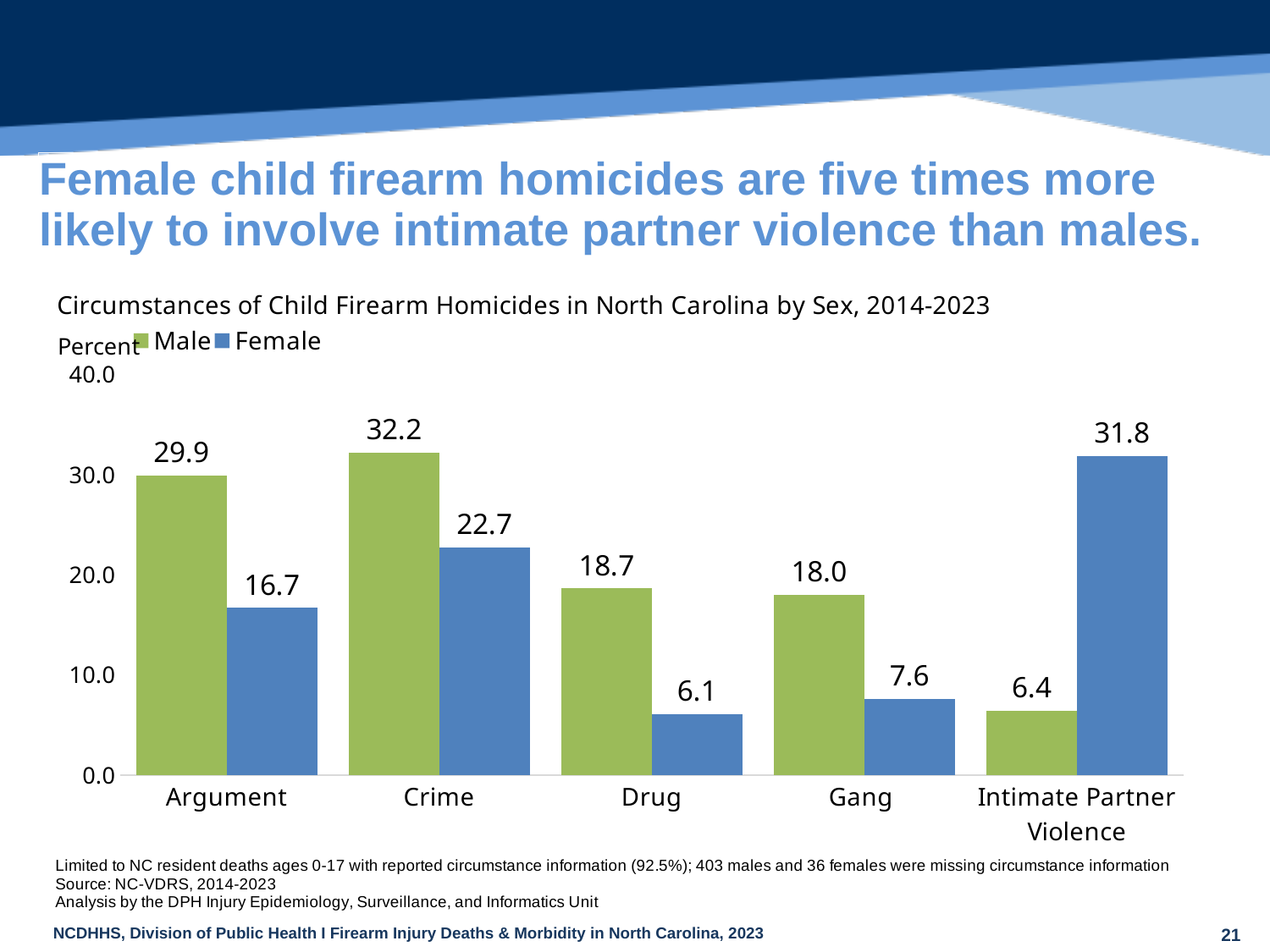
What is the Female value for Drug? 6.1 Is the Male value for Argument greater or less than 20.0? greater What kind of chart is shown on the slide? Bar chart What is the Male value for Crime? 32.2 How many series does the legend list? 2 What is the Female value for Intimate Partner Violence? 31.8 How many circumstance categories are shown on the x axis? 5 Which circumstance has the highest Male value? Crime Which is larger for Gang, the Male value or the Female value? Male Which circumstance has the lowest Female value? Drug What is the difference between the Female and Male values for Intimate Partner Violence? 25.4 What is the title of the chart? Circumstances of Child Firearm Homicides in North Carolina by Sex, 2014-2023